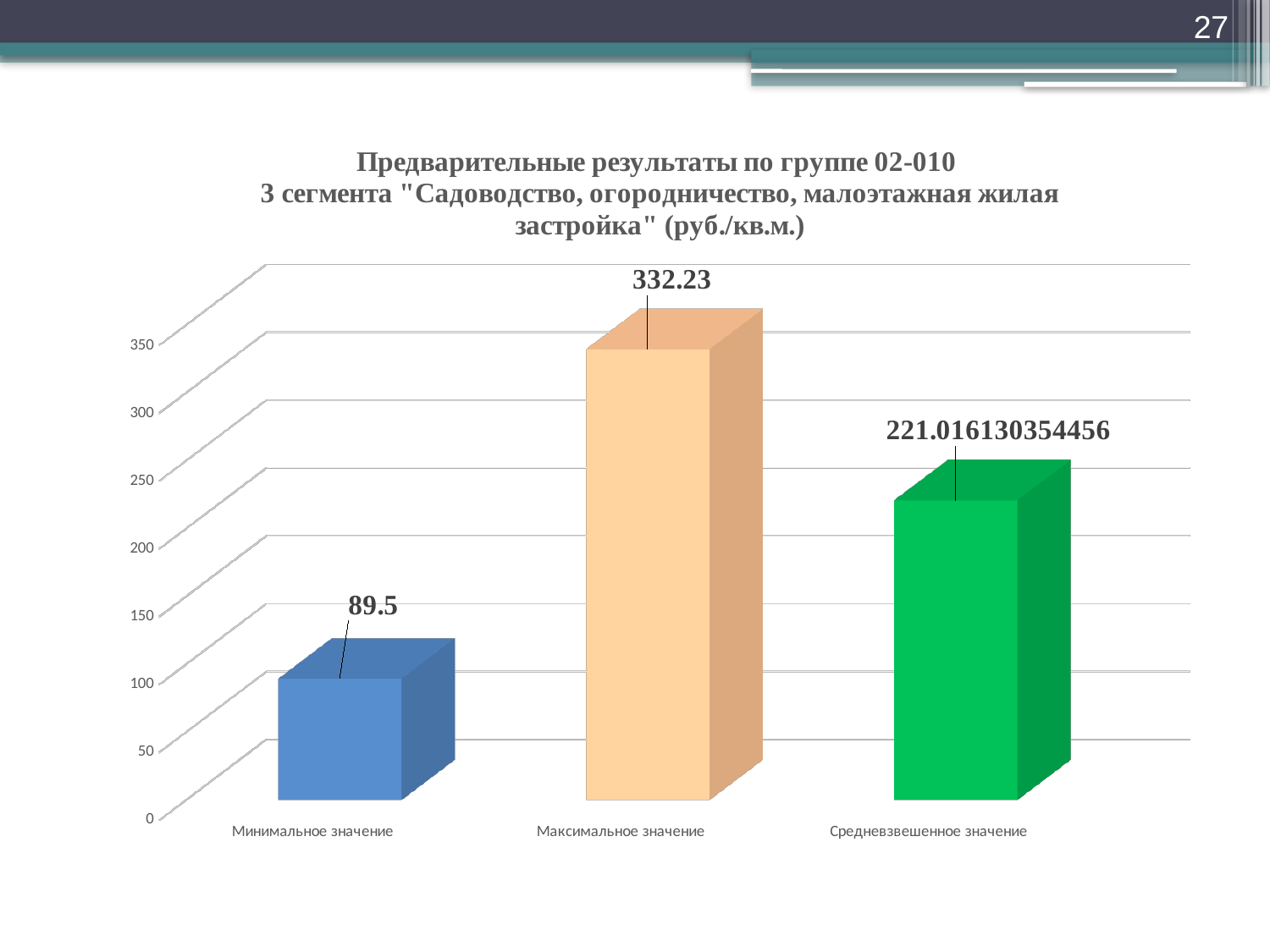
How many categories are shown on the chart? 3 What is the value for Максимальное значение? 332.23 What is the difference between the values for Максимальное значение and Минимальное значение? 242.73 Is the value for Средневзвешенное значение greater or less than 200? greater What colour is the bar for Максимальное значение? orange (peach) What is the value for Средневзвешенное значение? 221.016130354456 What is the value for Минимальное значение? 89.5 What kind of chart is shown on the slide? bar chart Is the value for Минимальное значение greater or less than 100? less Which category has the highest value? Максимальное значение Which category has the lowest value? Минимальное значение Which is larger, the value for Средневзвешенное значение or the value for Минимальное значение? Средневзвешенное значение